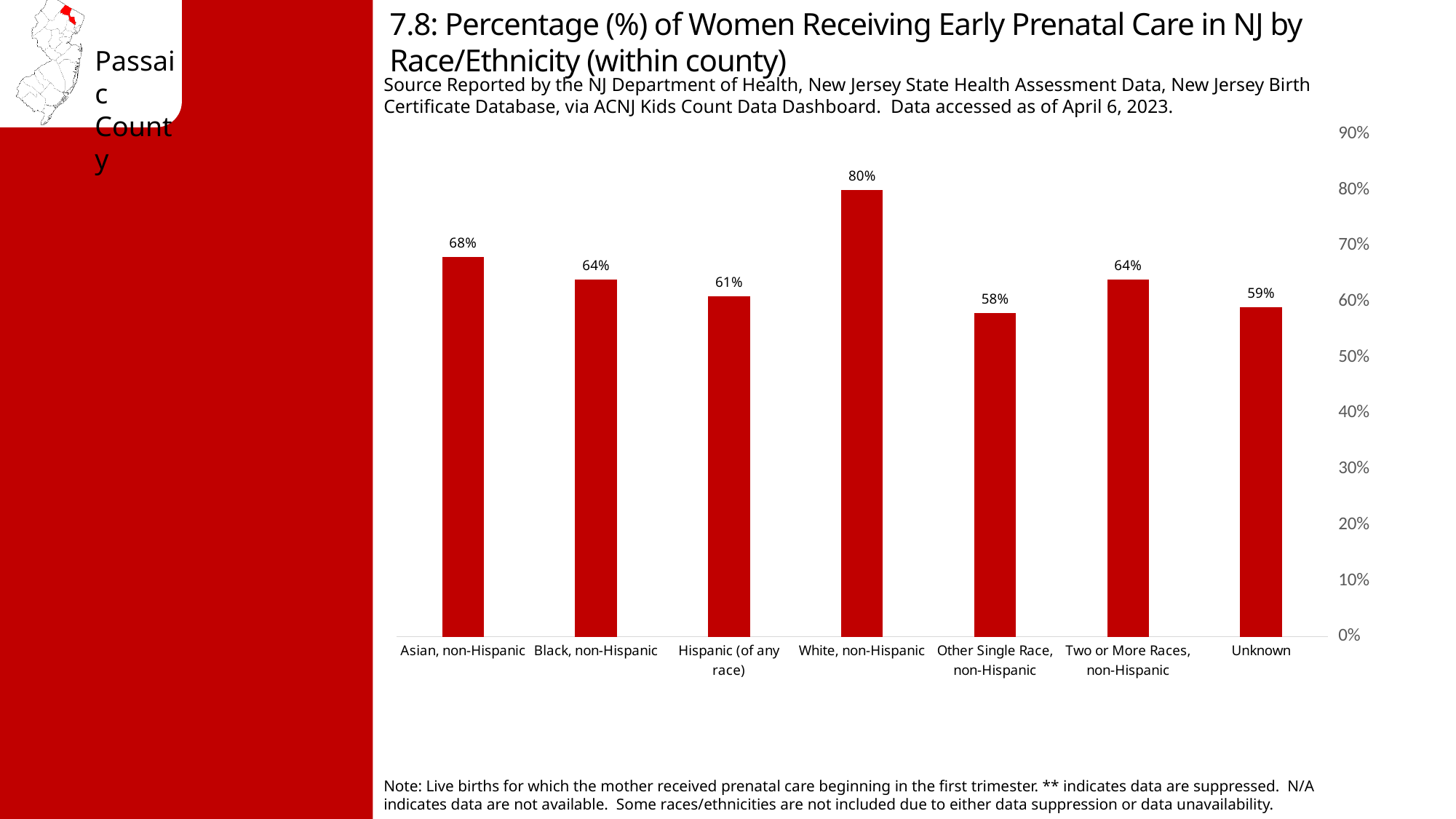
Which race/ethnicity category has the lowest percentage? Other Single Race, non-Hispanic What percentage of Asian, non-Hispanic women received early prenatal care? 68% Which county does the slide refer to? Passaic County What is the value shown for Unknown? 59% Which is larger, the value for Asian, non-Hispanic or the value for Two or More Races, non-Hispanic? Asian, non-Hispanic Which race/ethnicity category has the highest percentage of women receiving early prenatal care? White, non-Hispanic What is the value shown for Hispanic (of any race)? 61% What is the difference between the values for White, non-Hispanic and Black, non-Hispanic? 16% How many race/ethnicity categories are shown on the chart? 7 What kind of chart is shown on the slide? Bar chart Is the value for White, non-Hispanic greater or less than 70%? greater What is the value shown for Other Single Race, non-Hispanic? 58%